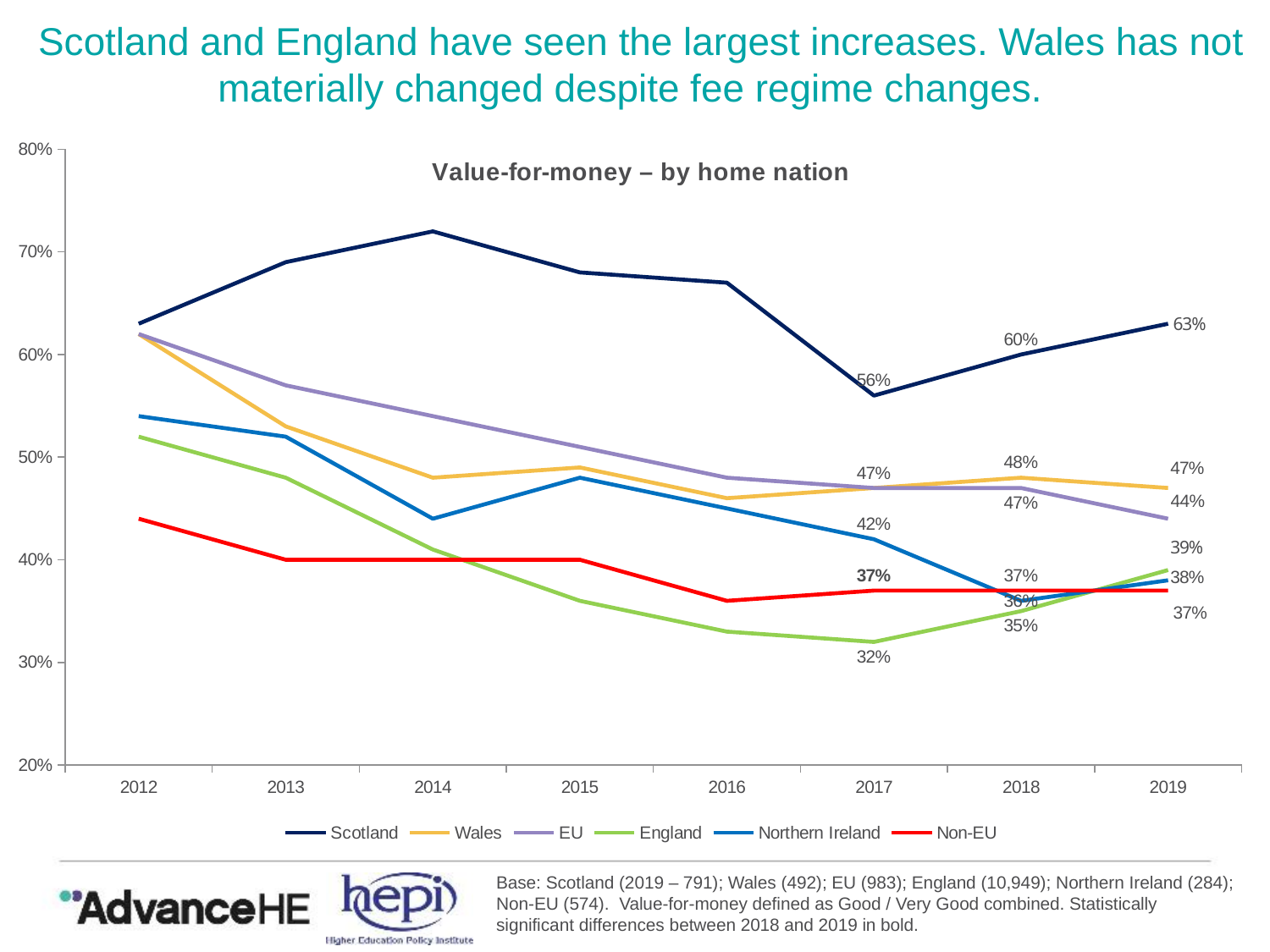
What is the value for Scotland in 2019? 63% What type of chart is shown on the slide? line chart Is the value for Scotland in 2014 greater or less than 70%? greater What is the chart's title? Value-for-money – by home nation How many years are shown on the x axis? 8 Which series has the lowest value in 2017? England What is the value for EU in 2019? 44% How many series does the legend list? 6 What is the value for Wales in 2018? 48% What is the value for England in 2017? 32% What is the difference between Scotland and England in 2019? 24 percentage points Which series has the highest value in 2019? Scotland